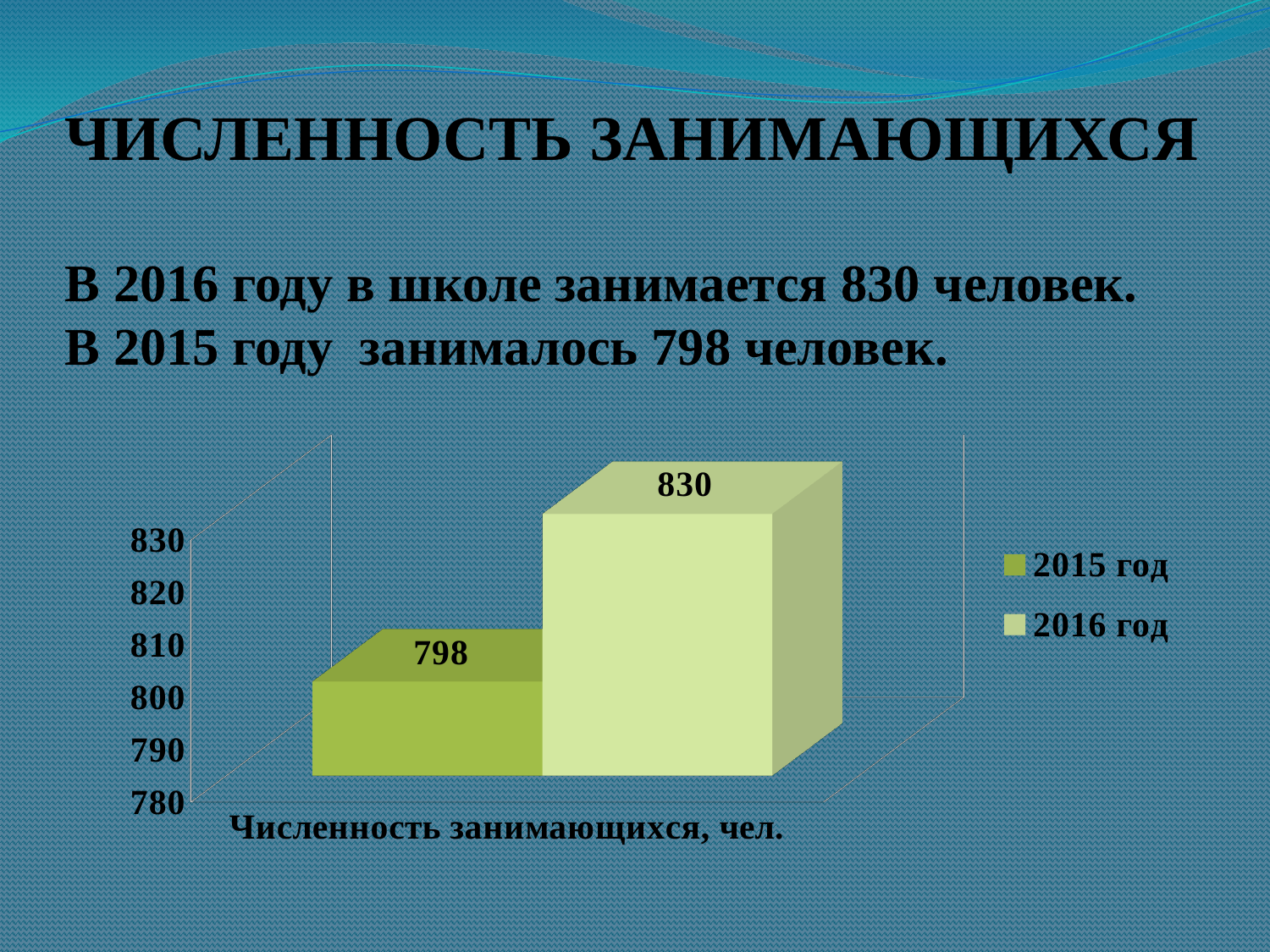
Which series has the highest value? 2016 год Is the value for 2016 год greater or less than 820? greater Which series has the lowest value? 2015 год Which is larger, the value for 2015 год or the value for 2016 год? 2016 год How many series does the legend list? 2 What is the value for 2015 год? 798 What is the lowest value shown on the vertical axis of the chart? 780 What kind of chart is shown on the slide? bar chart What is the label on the category axis of the chart? Численность занимающихся, чел. Is the value for 2015 год greater or less than 800? less What is the value for 2016 год? 830 What is the difference between the values for 2016 год and 2015 год? 32